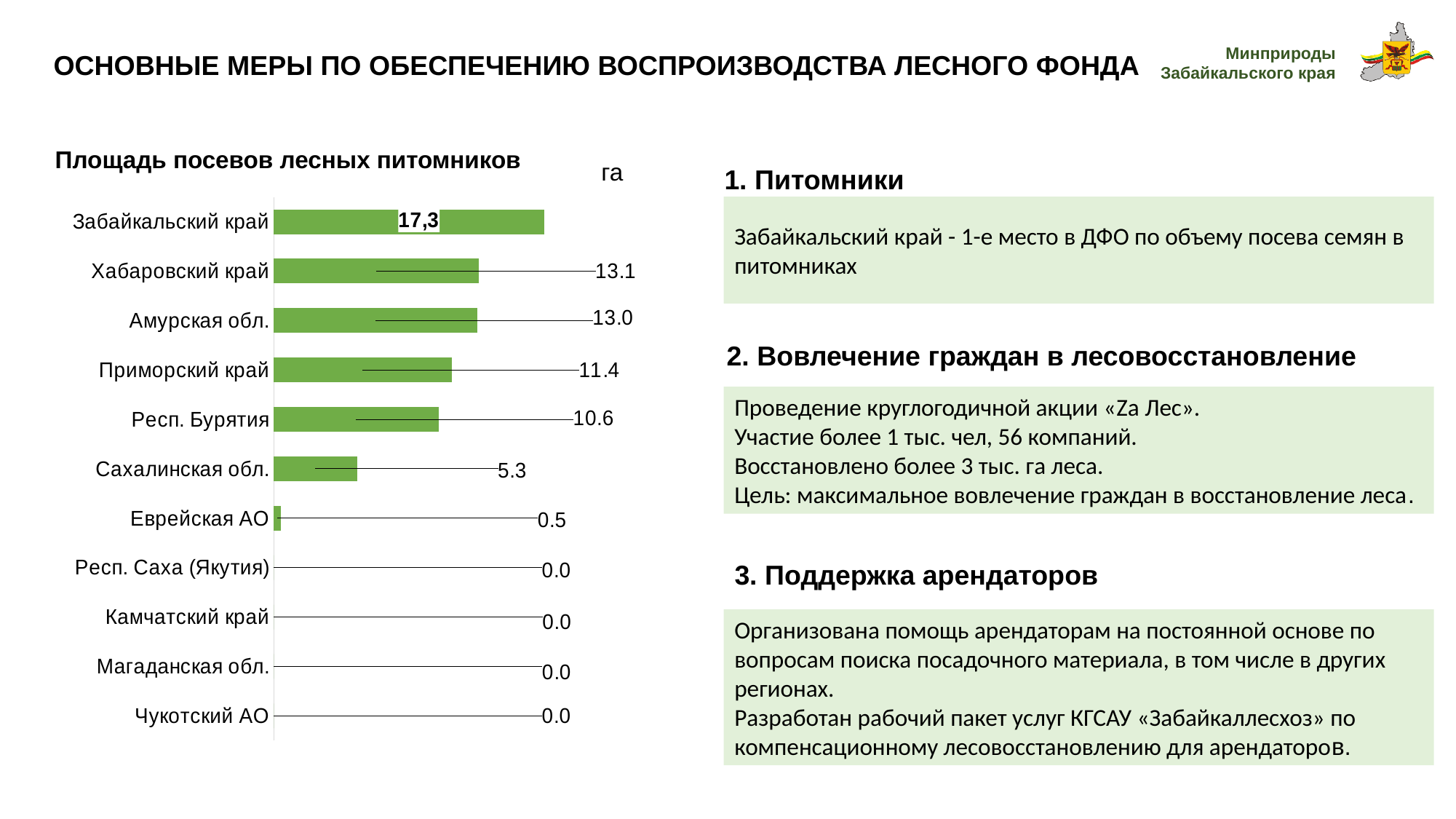
What is the difference between the values for Приморский край and Сахалинская обл.? 6.1 How many regions are listed in the chart? 11 What is the value for Еврейская АО? 0.5 Which is larger, the value for Приморский край or the value for Респ. Бурятия? Приморский край What unit is shown for the chart values? га What is the difference between the values for Хабаровский край and Амурская обл.? 0.1 What is the value for Хабаровский край? 13.1 How many regions have a value of 0.0? 4 What is the value for Забайкальский край in the chart? 17,3 What is the value for Респ. Бурятия? 10.6 Which region has the highest value in the chart? Забайкальский край What type of chart is shown on the slide? bar chart